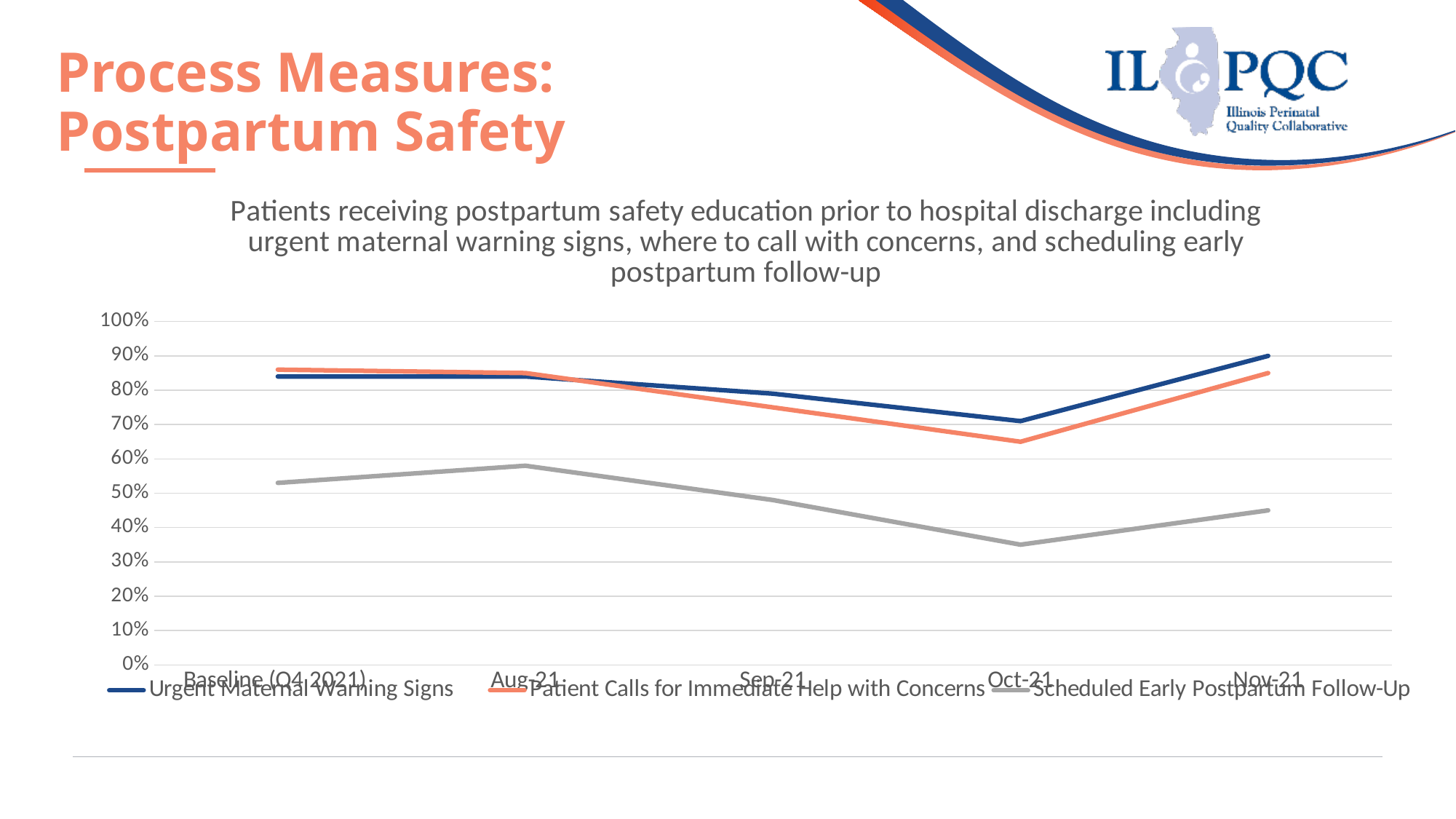
Is the value for Scheduled Early Postpartum Follow-Up at Oct-21 greater or less than 40%? less Is the value for Urgent Maternal Warning Signs at Baseline (Q4 2021) greater or less than 80%? greater At which time point is the Scheduled Early Postpartum Follow-Up series lowest? Oct-21 How many series does the legend list? 3 At Nov-21, which is larger: Urgent Maternal Warning Signs or Scheduled Early Postpartum Follow-Up? Urgent Maternal Warning Signs Does the Scheduled Early Postpartum Follow-Up series rise or fall from Aug-21 to Oct-21? Fall How many time points are plotted along the x axis? 5 What colour is the line for Patient Calls for Immediate Help with Concerns? Orange At which time point is the Patient Calls for Immediate Help with Concerns series lowest? Oct-21 At which time point is the Urgent Maternal Warning Signs series highest? Nov-21 Is the value for Patient Calls for Immediate Help with Concerns at Oct-21 greater or less than 70%? less What kind of chart is shown on the slide? Line chart